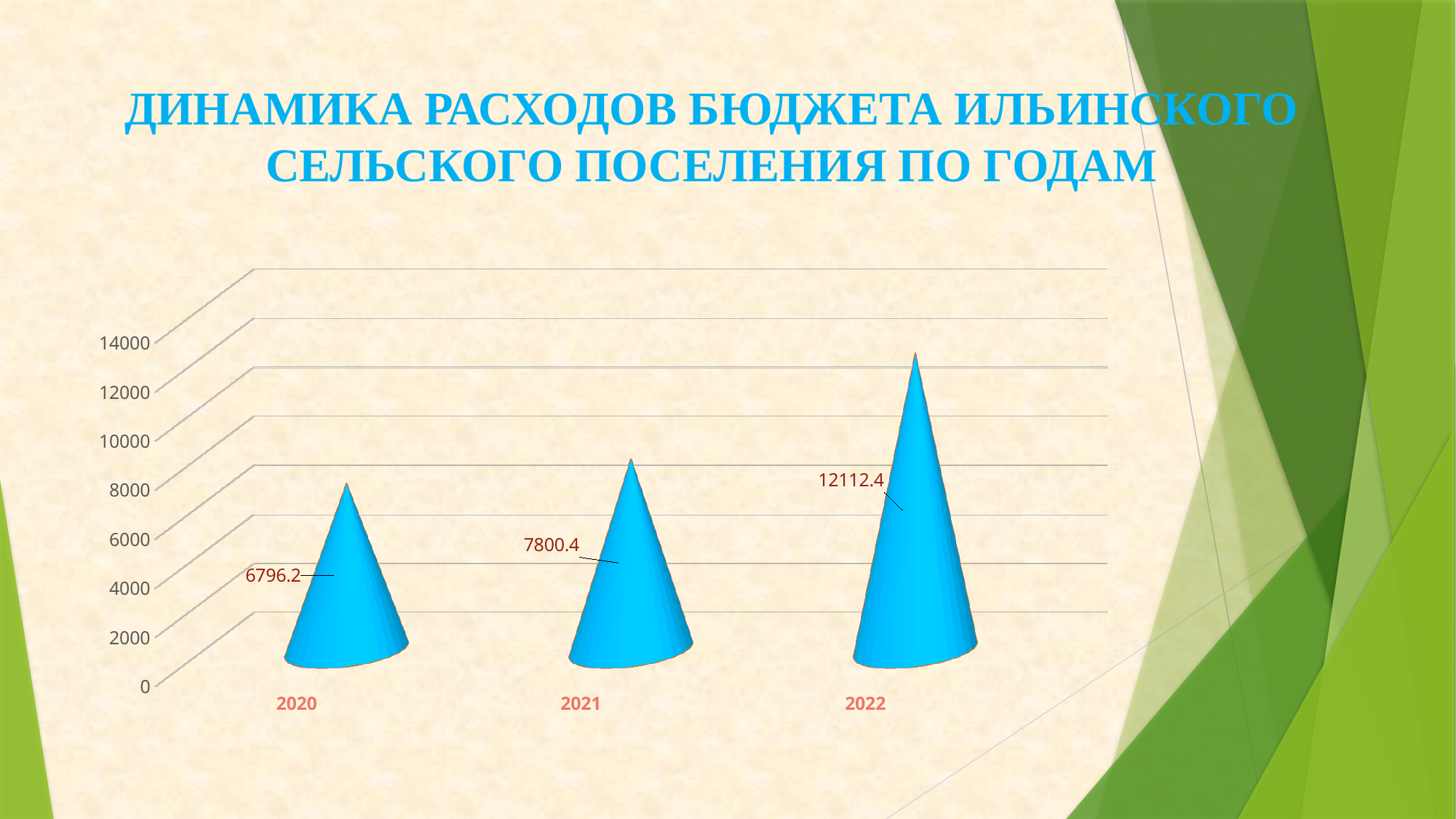
What is the budget expenditure value shown for 2021? 7800.4 How many years are shown on the chart? 3 What is the difference between the values for 2022 and 2021? 4312.0 Which is larger, the value for 2021 or the value for 2022? 2022 What is the difference between the values for 2021 and 2020? 1004.2 Do the values rise or fall from 2020 to 2022? rise What is the budget expenditure value shown for 2022? 12112.4 Which year has the highest budget expenditure? 2022 Is the value for 2022 greater or less than 10000? greater What is the budget expenditure value shown for 2020? 6796.2 Which year has the lowest budget expenditure? 2020 What kind of chart is shown on the slide? bar chart